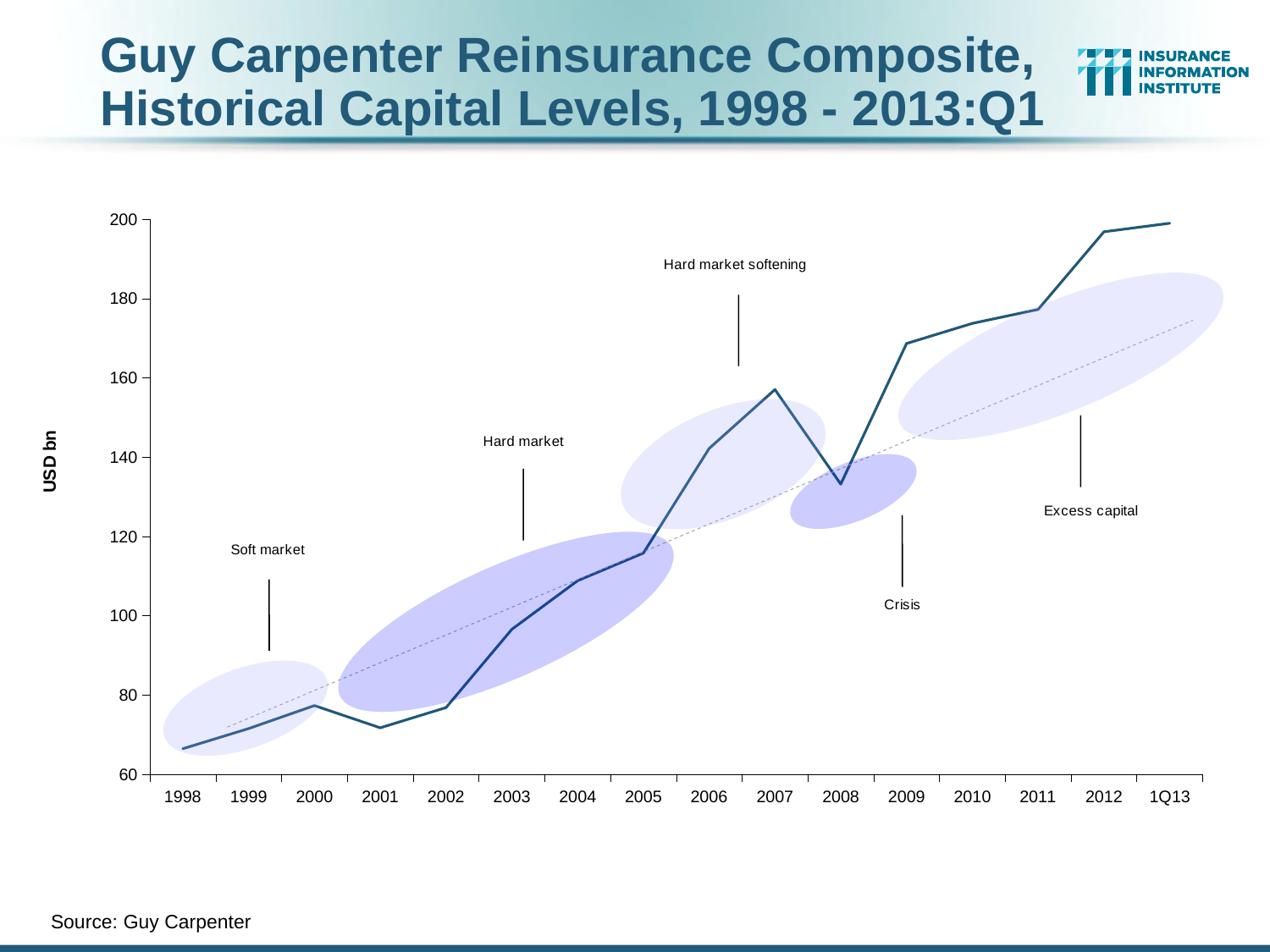
Which year has the lowest capital level on the chart? 1998 Is the value for 1998 greater or less than 80? less Is the value for 2012 greater or less than 180? greater Which is larger, the value for 2000 or the value for 2001? 2000 What kind of chart is shown on the slide? line chart Is the value for 2008 greater or less than 140? less What is the label on the y axis of the chart? USD bn Overall, do capital levels rise or fall from 1998 to 1Q13? rise Which is larger, the value for 2007 or the value for 2008? 2007 How many time periods are labelled on the x axis of the chart? 16